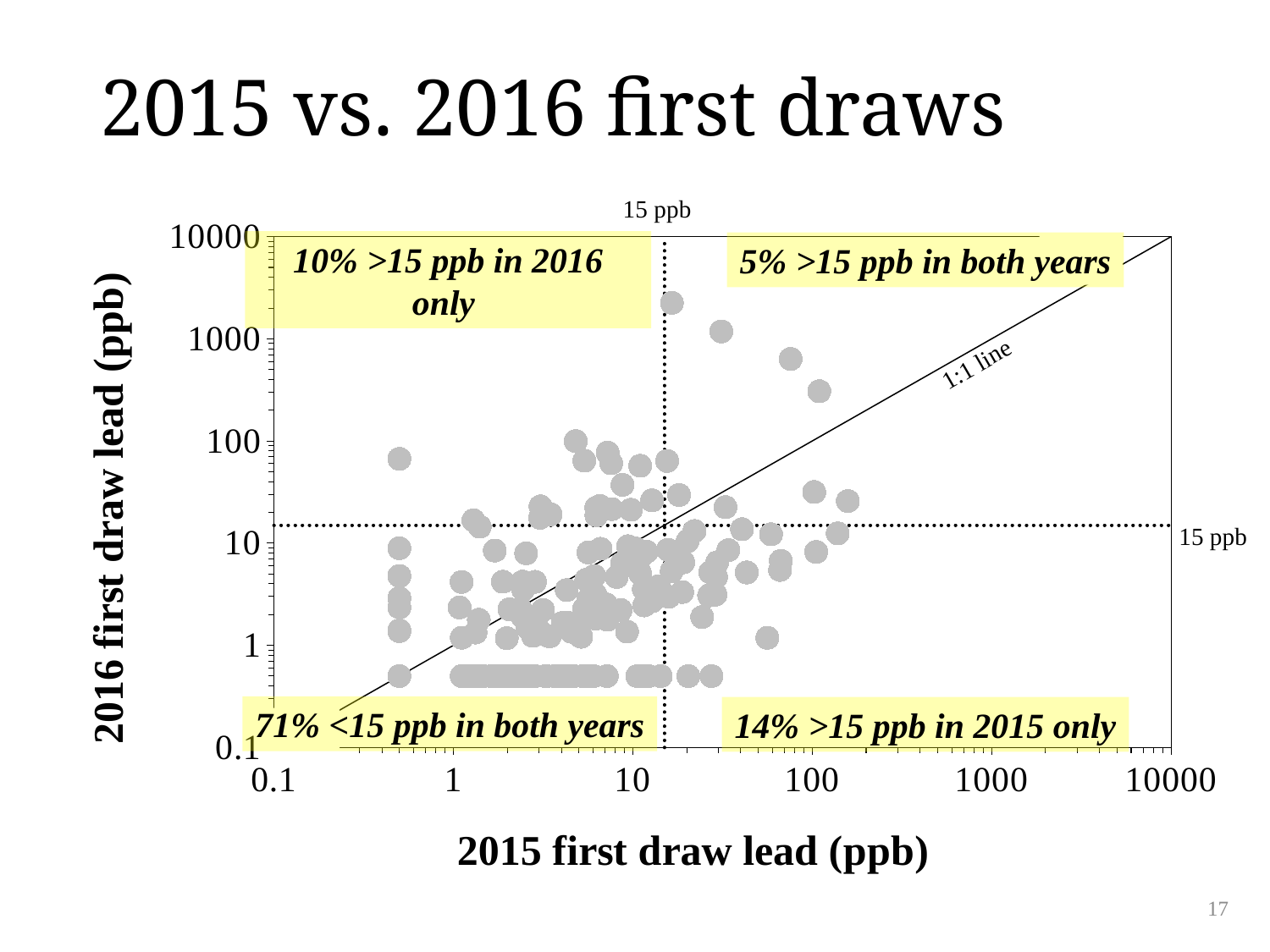
What percentage of samples were <15 ppb in both years? 71% What percentage of samples were >15 ppb in both years? 5% What is the label of the x axis? 2015 first draw lead (ppb) What is the title of the slide's chart? 2015 vs. 2016 first draws Which of the four quadrant categories has the largest percentage of samples? <15 ppb in both years What percentage of samples were >15 ppb in 2016 only? 10% Which of the four quadrant categories has the smallest percentage of samples? >15 ppb in both years How many percentage points larger is the share >15 ppb in 2015 only than the share >15 ppb in 2016 only? 4 At what lead concentration are the dotted threshold lines drawn on both axes? 15 ppb What kind of chart is shown on the slide? scatter plot What percentage of samples were >15 ppb in 2015 only? 14% Which is larger: the share >15 ppb in 2016 only or the share >15 ppb in 2015 only? >15 ppb in 2015 only